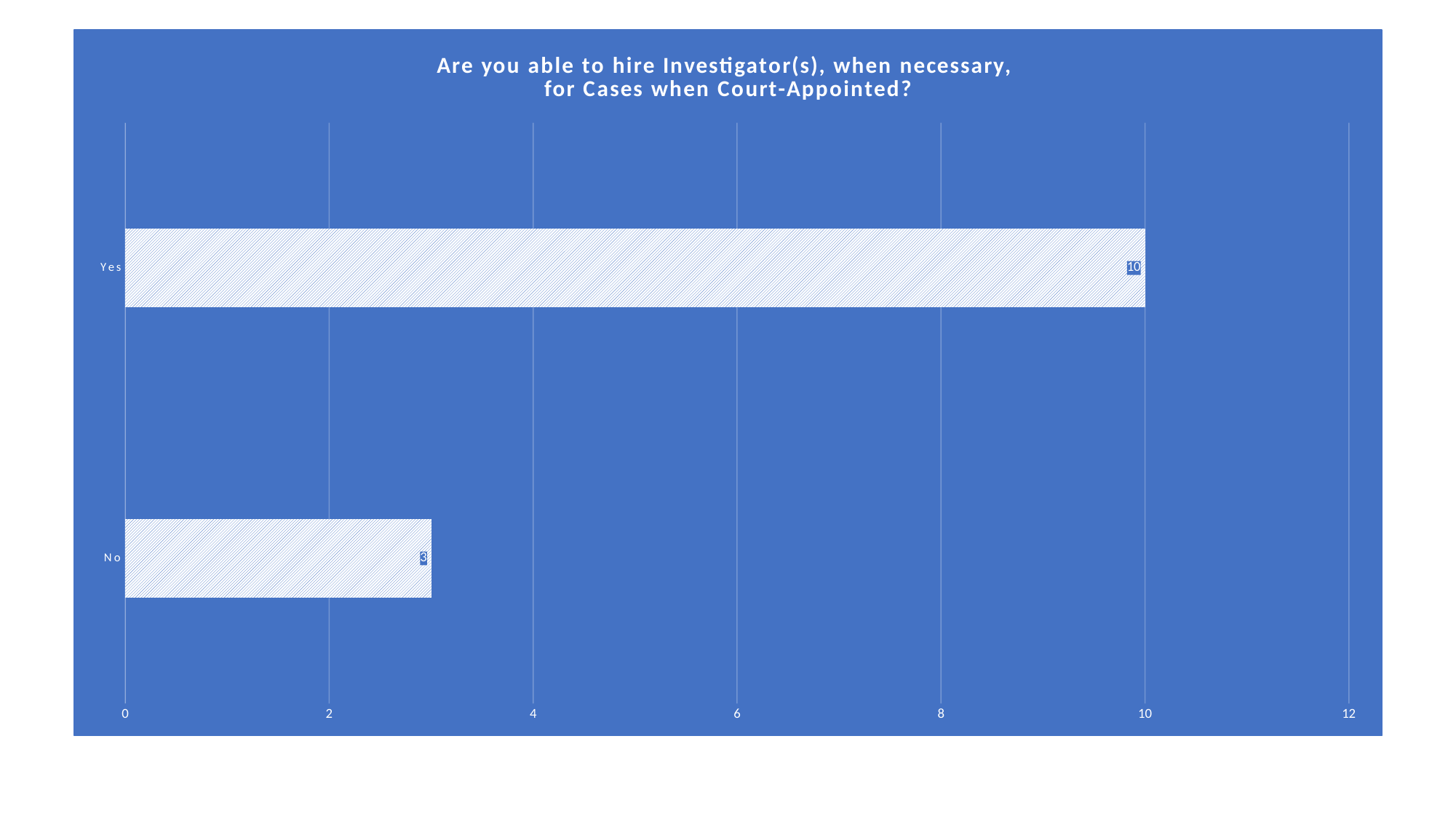
What is the value for No? 3 What is the value for Yes? 10 Which category has the lowest value? No Is the value for Yes greater or less than 8? greater What is the difference between the values for Yes and No? 7 Which is larger, the value for Yes or the value for No? Yes How many categories are shown in the chart? 2 Is the value for No greater or less than 4? less Which category has the highest value? Yes What is the title of the chart? Are you able to hire Investigator(s), when necessary, for Cases when Court-Appointed? What is the maximum value shown on the horizontal axis? 12 What kind of chart is shown on the slide? bar chart